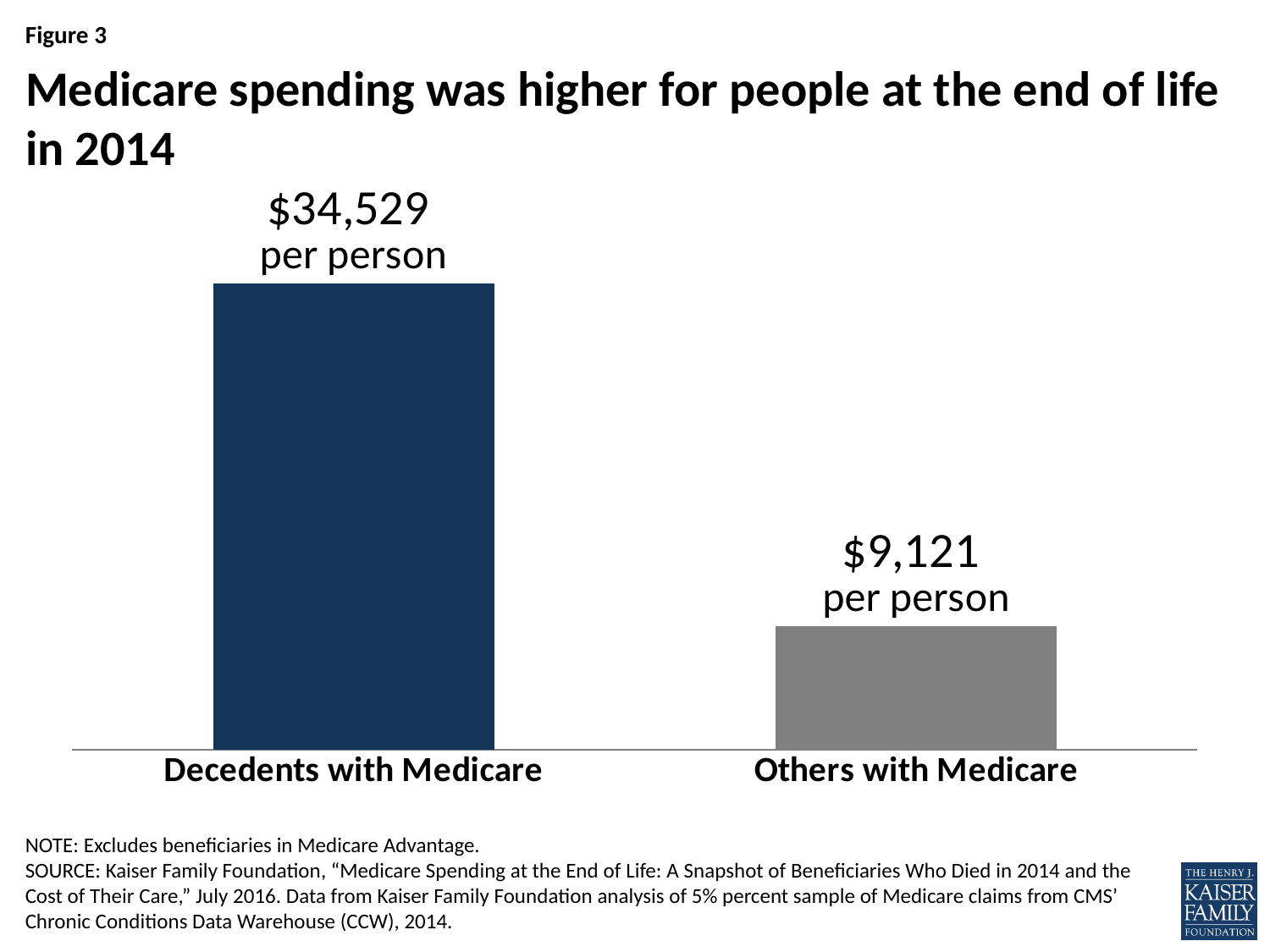
Is per-person spending larger for Decedents with Medicare or for Others with Medicare? Decedents with Medicare What is the Medicare spending per person for Others with Medicare? $9,121 What colour is the bar for Decedents with Medicare? Dark blue What is the Medicare spending per person for Decedents with Medicare? $34,529 What is the title of the chart? Medicare spending was higher for people at the end of life in 2014 What is the difference in per-person spending between Decedents with Medicare and Others with Medicare? $25,408 How many categories are shown in the chart? 2 Which category has the higher Medicare spending per person? Decedents with Medicare Which category has the lower Medicare spending per person? Others with Medicare What kind of chart is shown on the slide? Bar chart